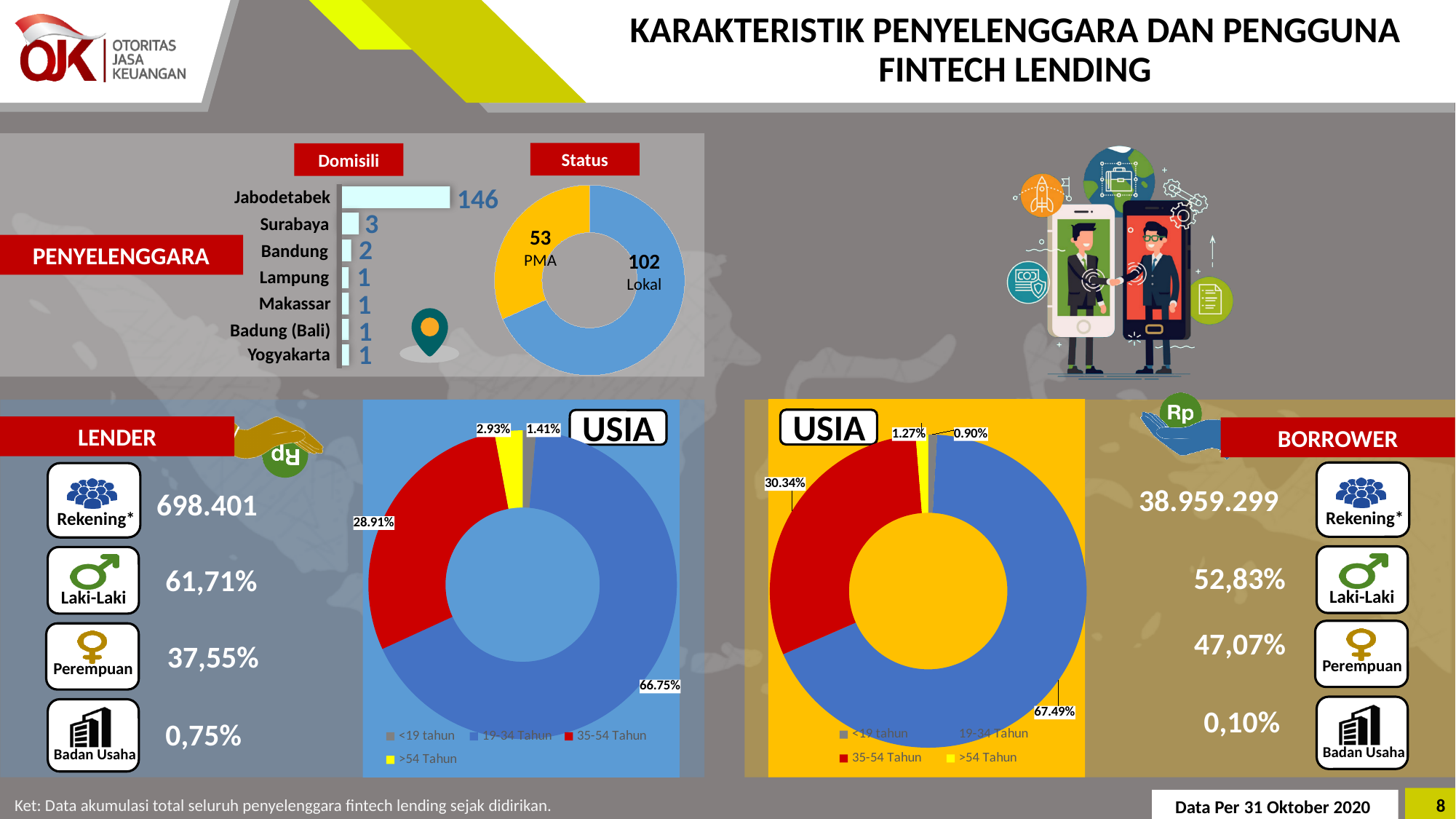
In the Status donut chart, what is the total of PMA and Lokal? 155 In the BORROWER USIA donut chart, which age group has the smallest share? <19 tahun In the BORROWER USIA donut chart, what is the share for 19-34 Tahun? 67.49% How many entries does the legend of the LENDER USIA donut chart list? 4 In the Status donut chart, what is the value for PMA? 53 In the LENDER USIA donut chart, what is the share for 35-54 Tahun? 28.91% In the Domisili bar chart, which category has the highest value? Jabodetabek In the Domisili bar chart, what is the value for Surabaya? 3 In the Domisili bar chart, what is the value for Jabodetabek? 146 In the Status donut chart, which is larger, PMA or Lokal? Lokal In the Domisili bar chart, what is the difference between Jabodetabek and Surabaya? 143 How many categories does the Domisili bar chart show? 7